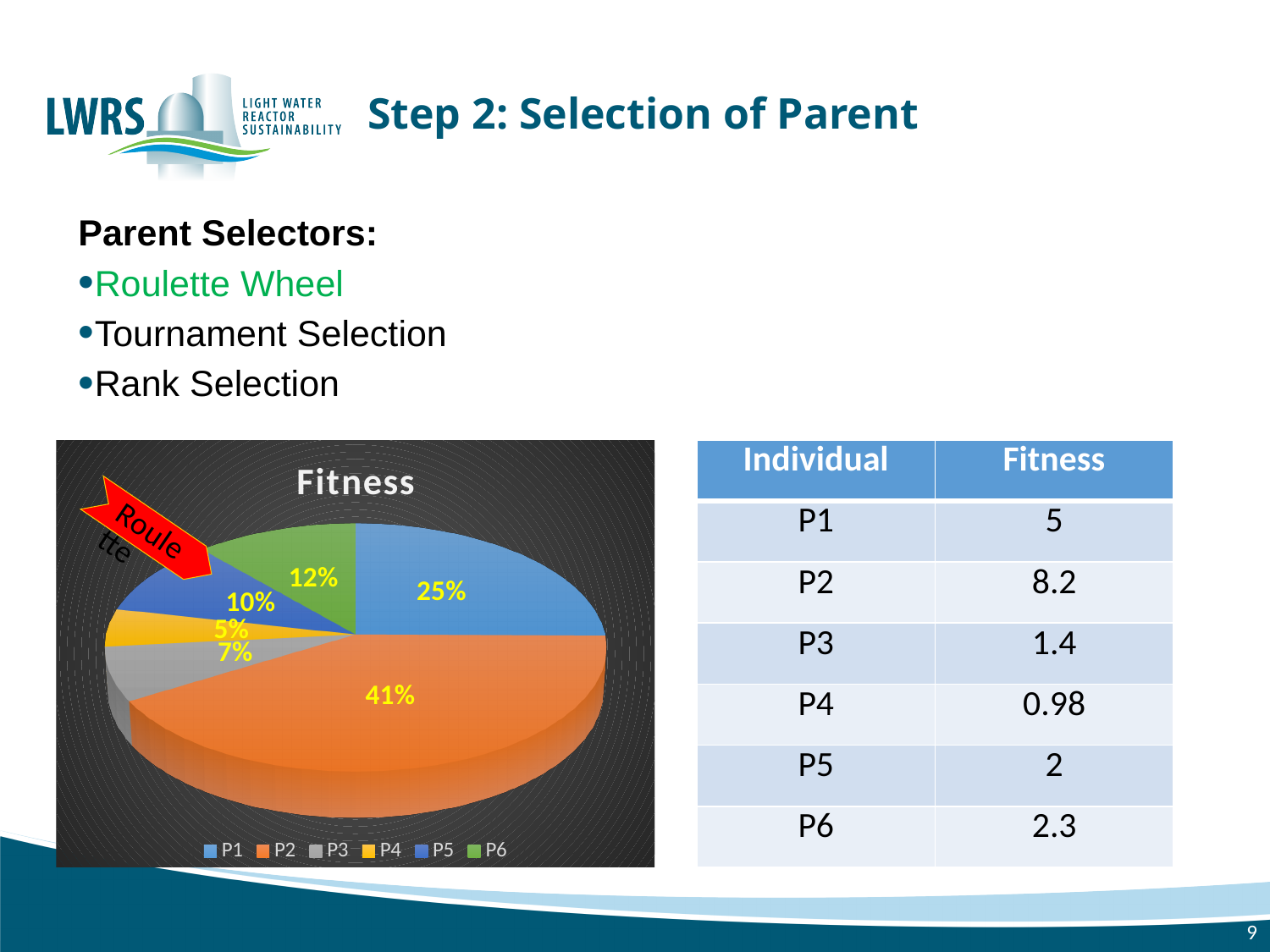
What is the title of the pie chart? Fitness What type of chart is shown on the slide? pie chart What share of the pie does P2 have? 41% How many entries does the legend of the pie chart list? 6 How many slices does the pie chart have? 6 What is the difference in percentage points between the P2 slice and the P1 slice? 16% Which slice is larger, P5 or P3? P5 What share of the pie does P6 have? 12% Which individual has the largest slice of the pie? P2 Which individual has the smallest slice of the pie? P4 What share of the pie does P4 have? 5%